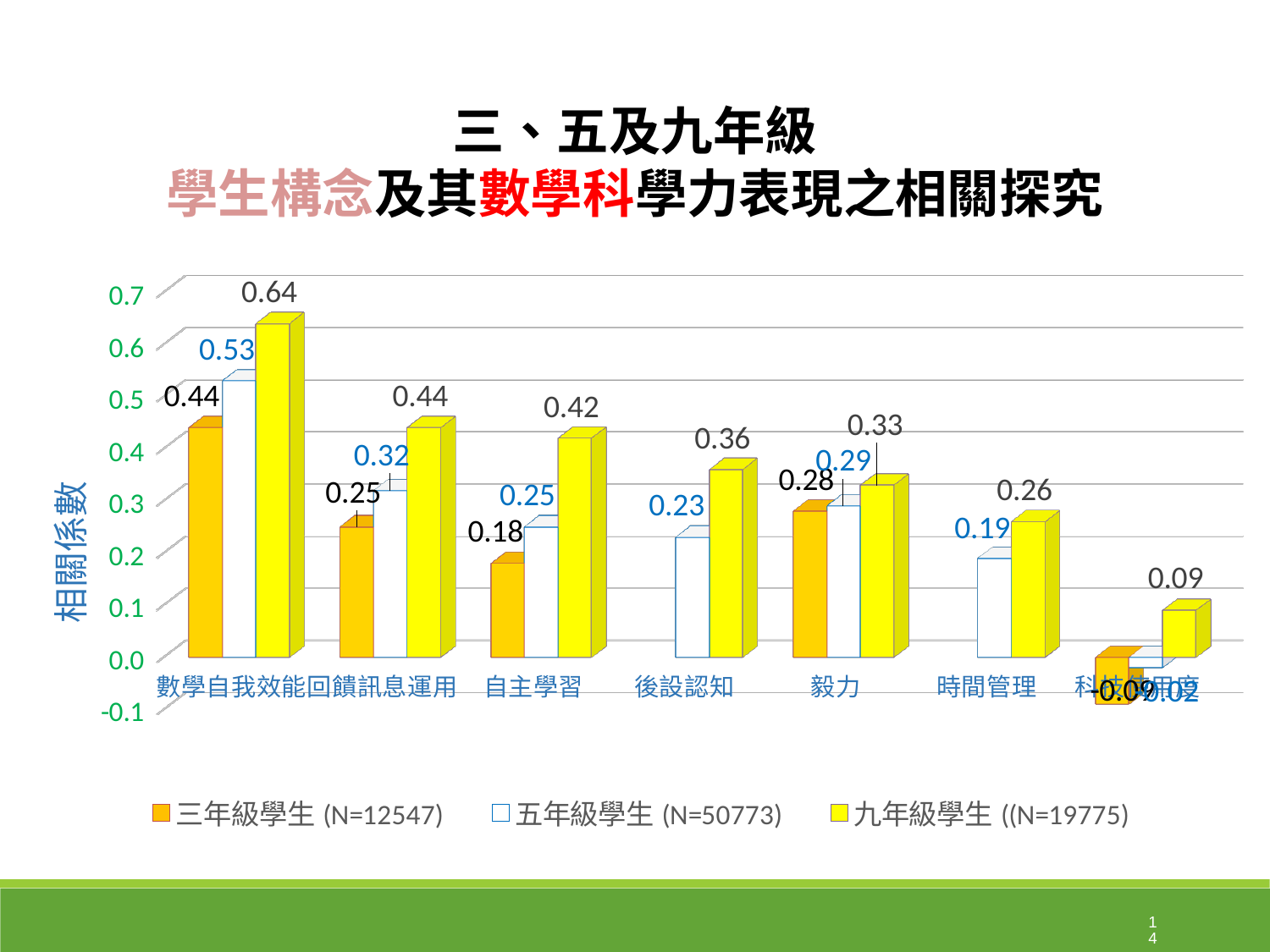
What is the value for 五年級學生 in the 時間管理 category? 0.19 How many categories are shown along the x axis? 7 What is the value for 九年級學生 in the 數學自我效能 category? 0.64 What kind of chart is shown on the slide? bar chart What is the value for 三年級學生 in the 毅力 category? 0.28 What is the difference between the 九年級學生 and 三年級學生 values in the 數學自我效能 category? 0.20 What is the value for 五年級學生 in the 回饋訊息運用 category? 0.32 What is the title of the vertical axis? 相關係數 Which category has the highest value for 九年級學生? 數學自我效能 For 九年級學生, which is larger: the value for 後設認知 or the value for 毅力? 後設認知 What is the value for 三年級學生 in the 自主學習 category? 0.18 How many series does the legend list? 3